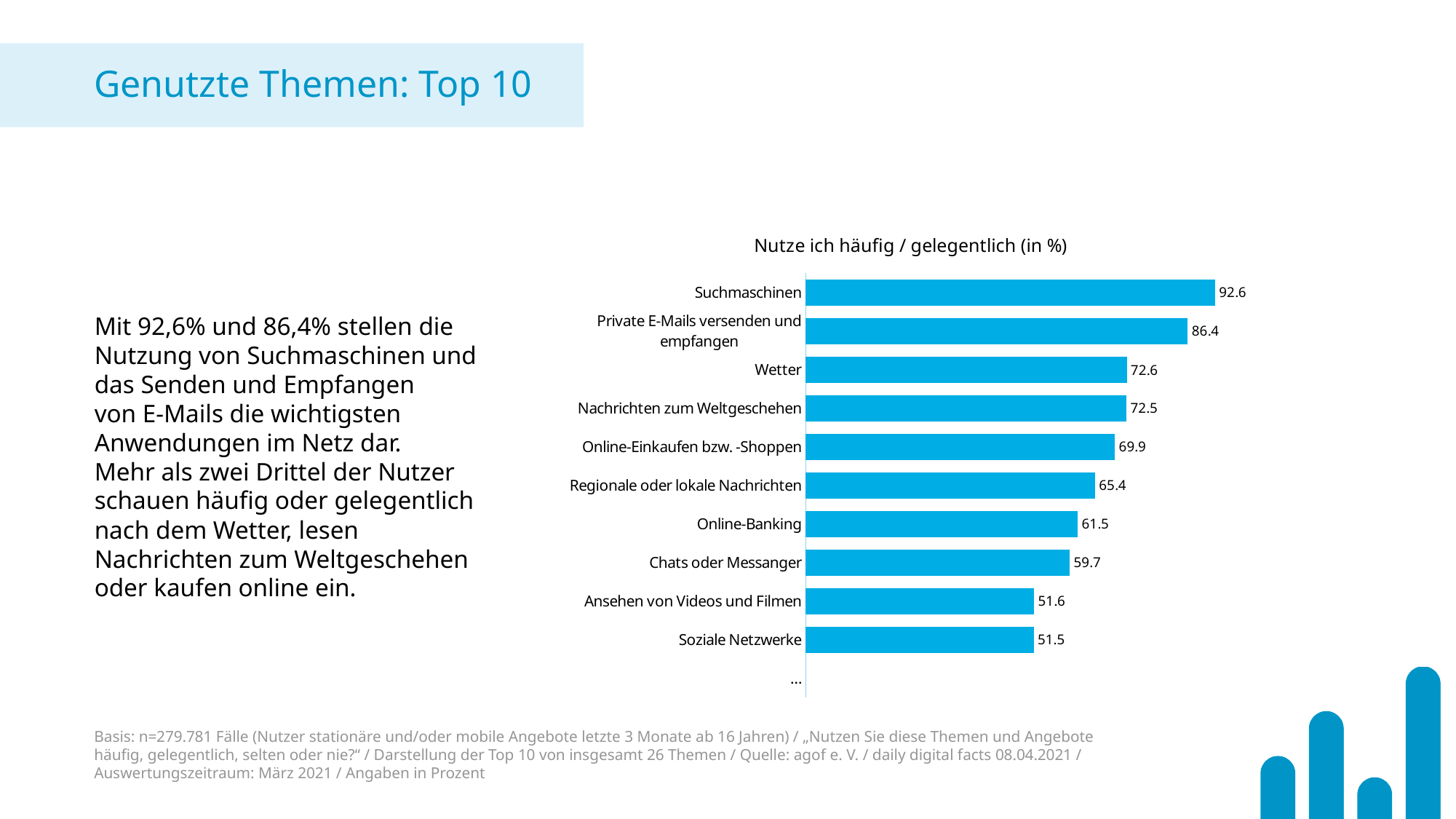
What is the value for Online-Einkaufen bzw. -Shoppen? 69.9 What is the title of the chart? Nutze ich häufig / gelegentlich (in %) What is the difference between the values for Online-Banking and Chats oder Messanger? 1.8 What is the value for Regionale oder lokale Nachrichten? 65.4 Which category has the highest value? Suchmaschinen What kind of chart is shown on the slide? Bar chart What is the value for Suchmaschinen? 92.6 What is the value for Soziale Netzwerke? 51.5 How many bars are plotted in the chart? 10 What is the difference between the values for Suchmaschinen and Private E-Mails versenden und empfangen? 6.2 Which category has the lowest value among the bars shown? Soziale Netzwerke Which is larger, the value for Online-Banking or the value for Chats oder Messanger? Online-Banking